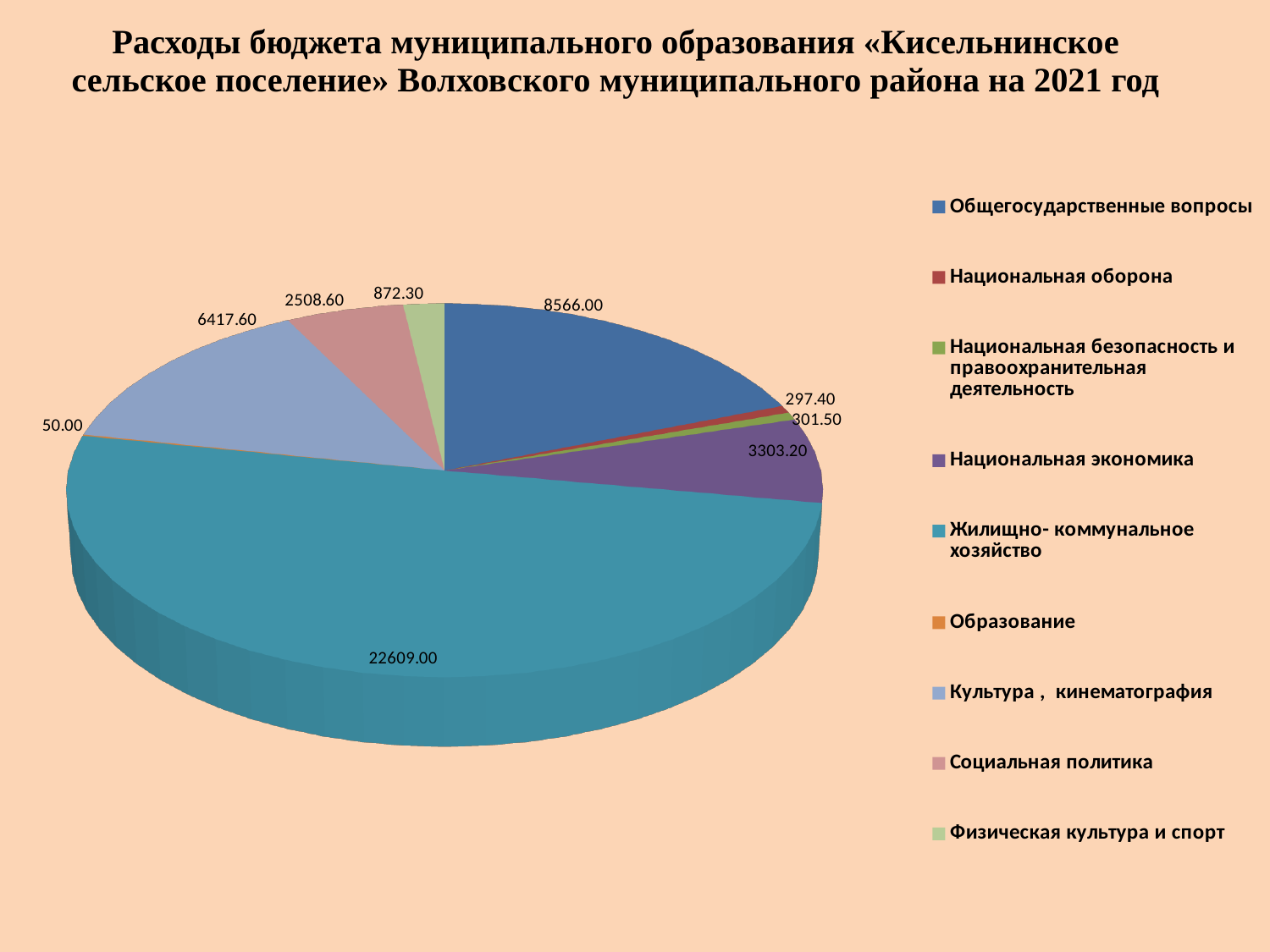
What is the value for Физическая культура и спорт? 872.30 Which category has the smallest slice of the pie? Образование Which is larger: Национальная экономика or Социальная политика? Национальная экономика What type of chart is shown on the slide? Pie chart What is the value for Культура, кинематография? 6417.60 What is the value for Жилищно-коммунальное хозяйство? 22609.00 What is the difference between the values for Общегосударственные вопросы and Культура, кинематография? 2148.40 What is the total of all the values shown on the pie chart? 44925.60 How many categories does the legend of the pie chart list? 9 Which category has the largest slice of the pie? Жилищно-коммунальное хозяйство What is the value for Образование? 50.00 What is the value for Общегосударственные вопросы? 8566.00